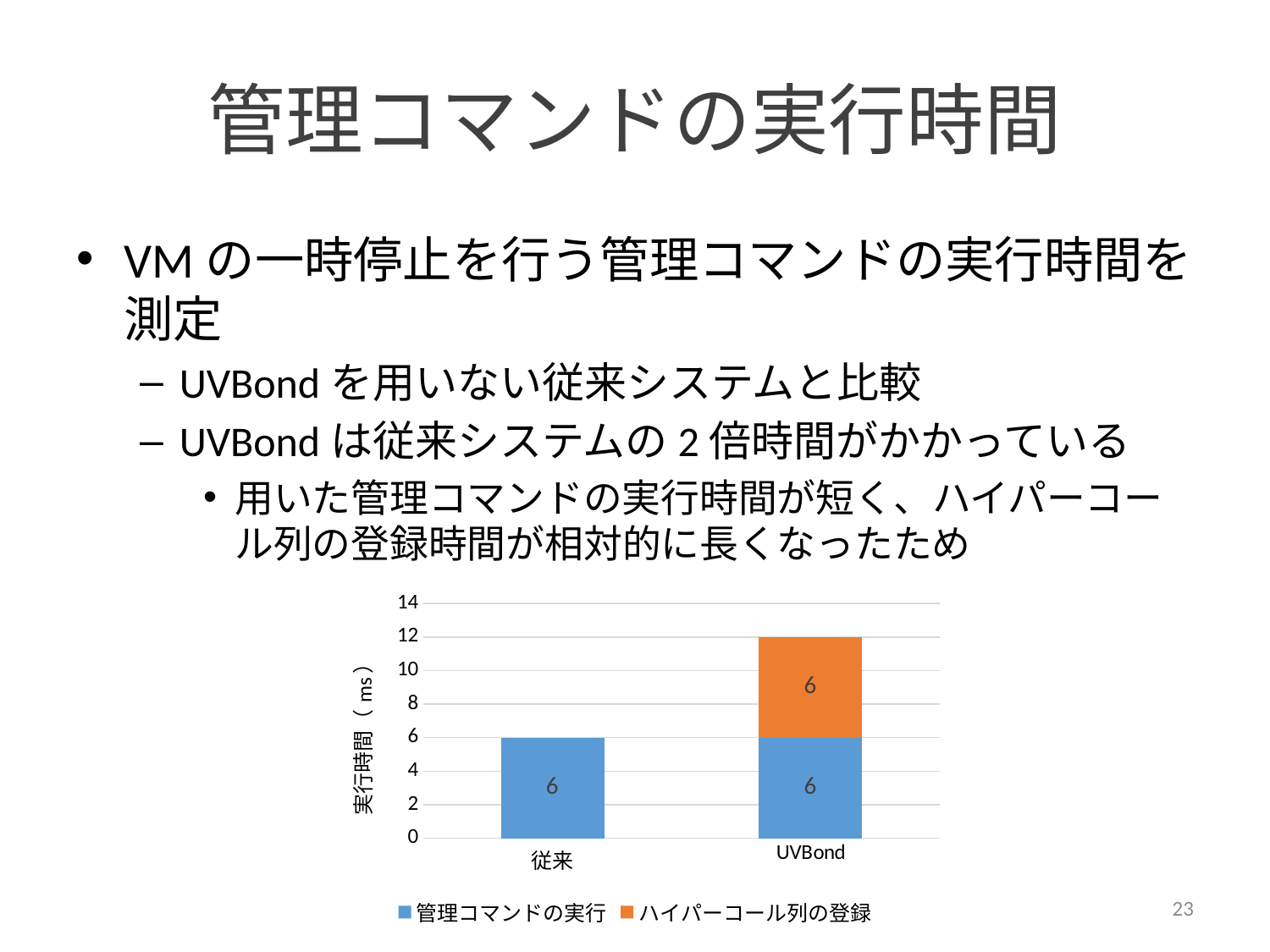
What is the total height of the stacked bar for UVBond? 12 What is the value of 管理コマンドの実行 for 従来? 6 Which series is shown in orange in the legend? ハイパーコール列の登録 Which category has the taller stacked bar, 従来 or UVBond? UVBond What is the difference between the total for UVBond and the total for 従来? 6 What is the value of ハイパーコール列の登録 for UVBond? 6 How many series does the legend list? 2 What is the y-axis label of the chart? 実行時間（ms） What is the value of 管理コマンドの実行 for UVBond? 6 What kind of chart is shown on the slide? Stacked bar chart Is the total for UVBond greater or less than 10? greater How many categories are shown on the x axis? 2